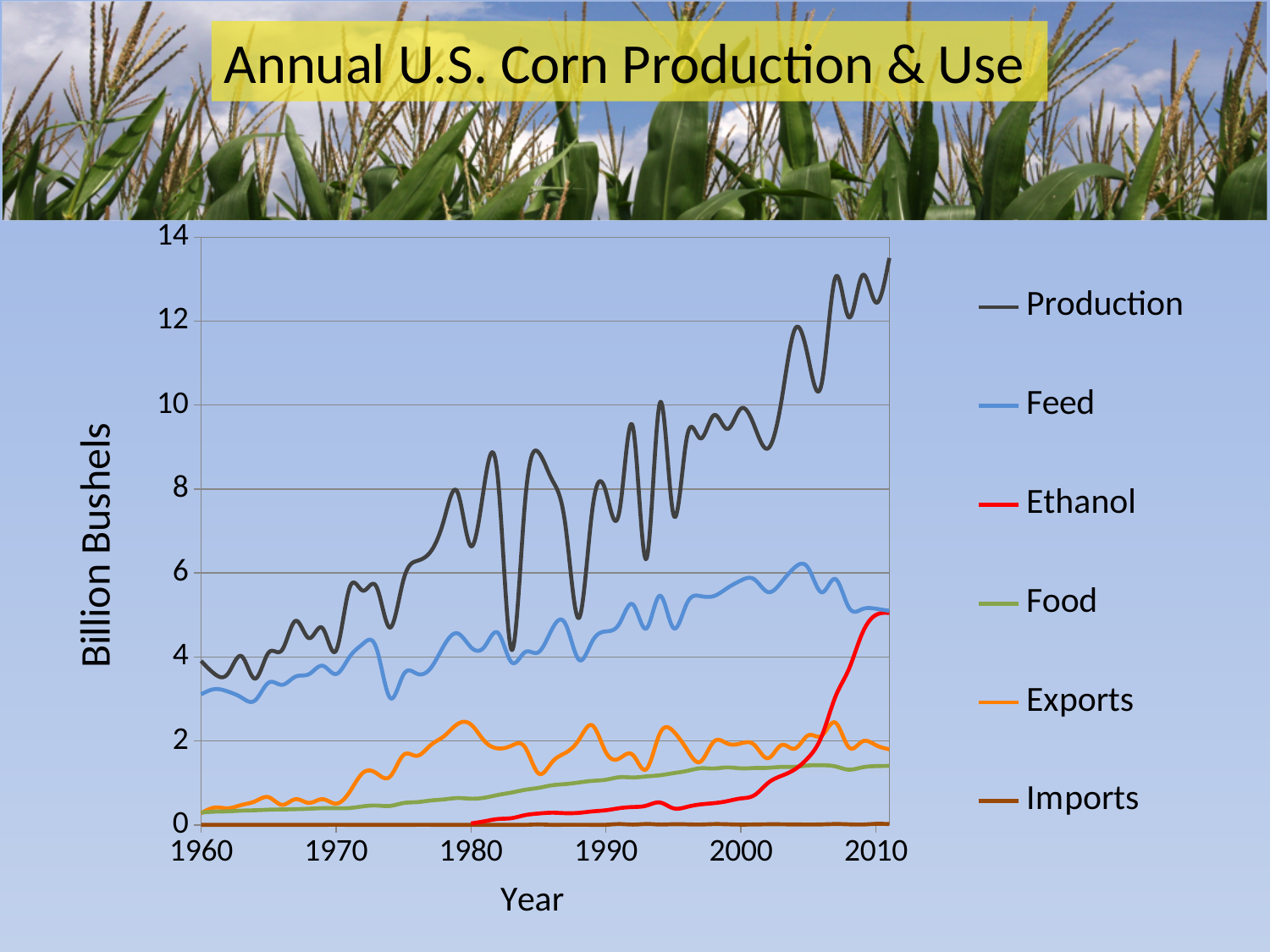
Which series has the lowest values across the chart? Imports What unit is shown on the vertical axis? Billion Bushels How many series does the legend list? 6 Which series has the highest values across the chart? Production What kind of chart is shown on the slide? line chart Is the value for Production in 2000 greater or less than 8? greater In 2000, which is larger, Feed or Exports? Feed Is the value for Ethanol in 1990 greater or less than 2? less Does the Production line generally rise or fall from 1960 to 2010? rise What is the title of the chart? Annual U.S. Corn Production & Use Is the value for Production in 1960 greater or less than 6? less Does the Ethanol line rise or fall between 2000 and 2010? rise